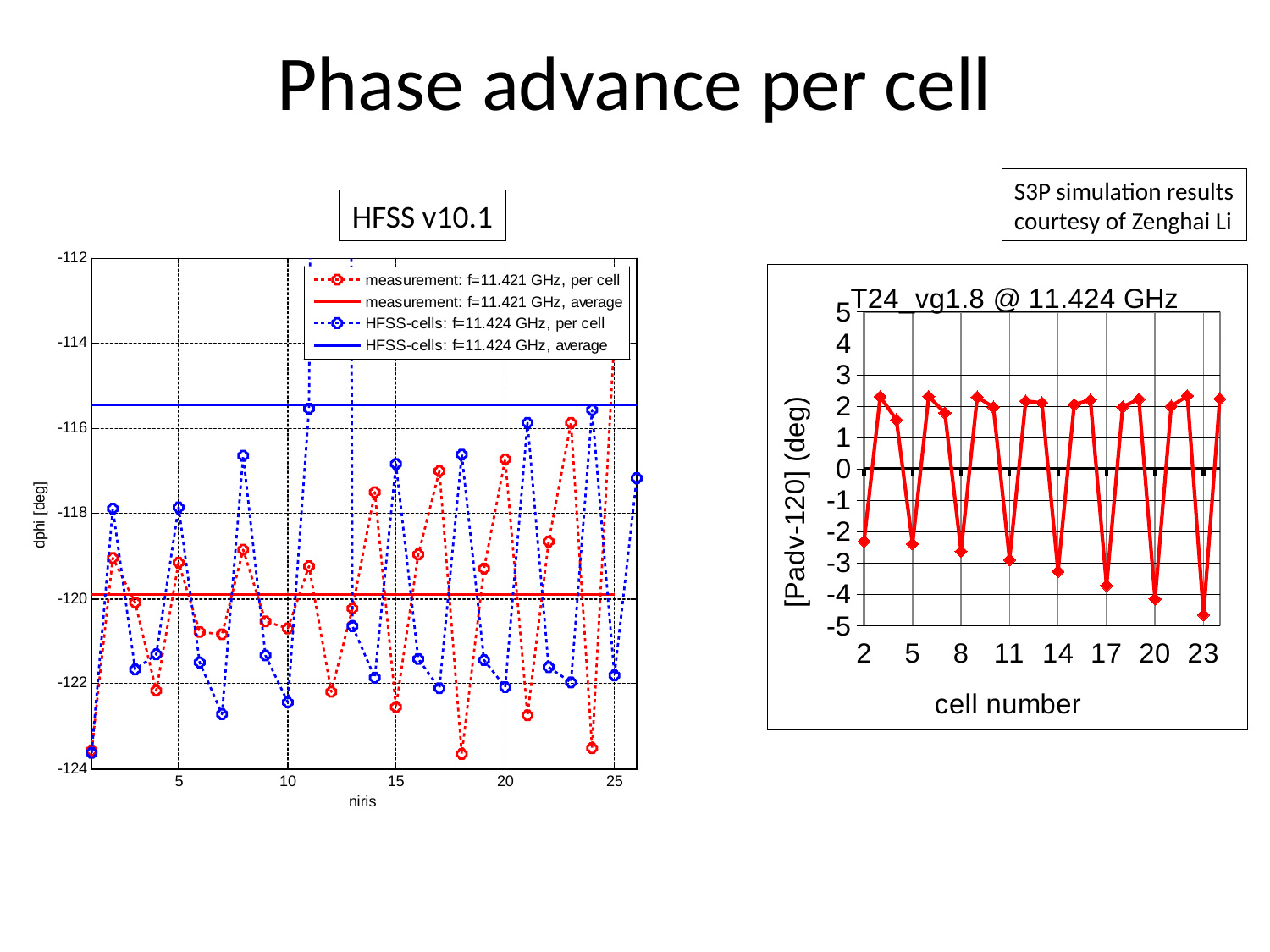
In the left HFSS v10.1 chart, is the 'HFSS-cells: f=11.424 GHz, average' line greater or less than -116? greater What is the title of the chart on the right? T24_vg1.8 @ 11.424 GHz In the right chart 'T24_vg1.8 @ 11.424 GHz', is the value at cell number 17 greater or less than -3? less In the left HFSS v10.1 chart, is the 'HFSS-cells: f=11.424 GHz, per cell' value at niris 7 greater or less than -122? less In the left HFSS v10.1 chart, what is the label of the x axis? niris How many series does the legend of the left HFSS v10.1 chart list? 4 In the right chart 'T24_vg1.8 @ 11.424 GHz', at which cell number is the lowest value? 23 What kind of chart is the HFSS v10.1 chart on the left? line chart In the right chart 'T24_vg1.8 @ 11.424 GHz', which is lower, the value at cell number 2 or at cell number 23? cell number 23